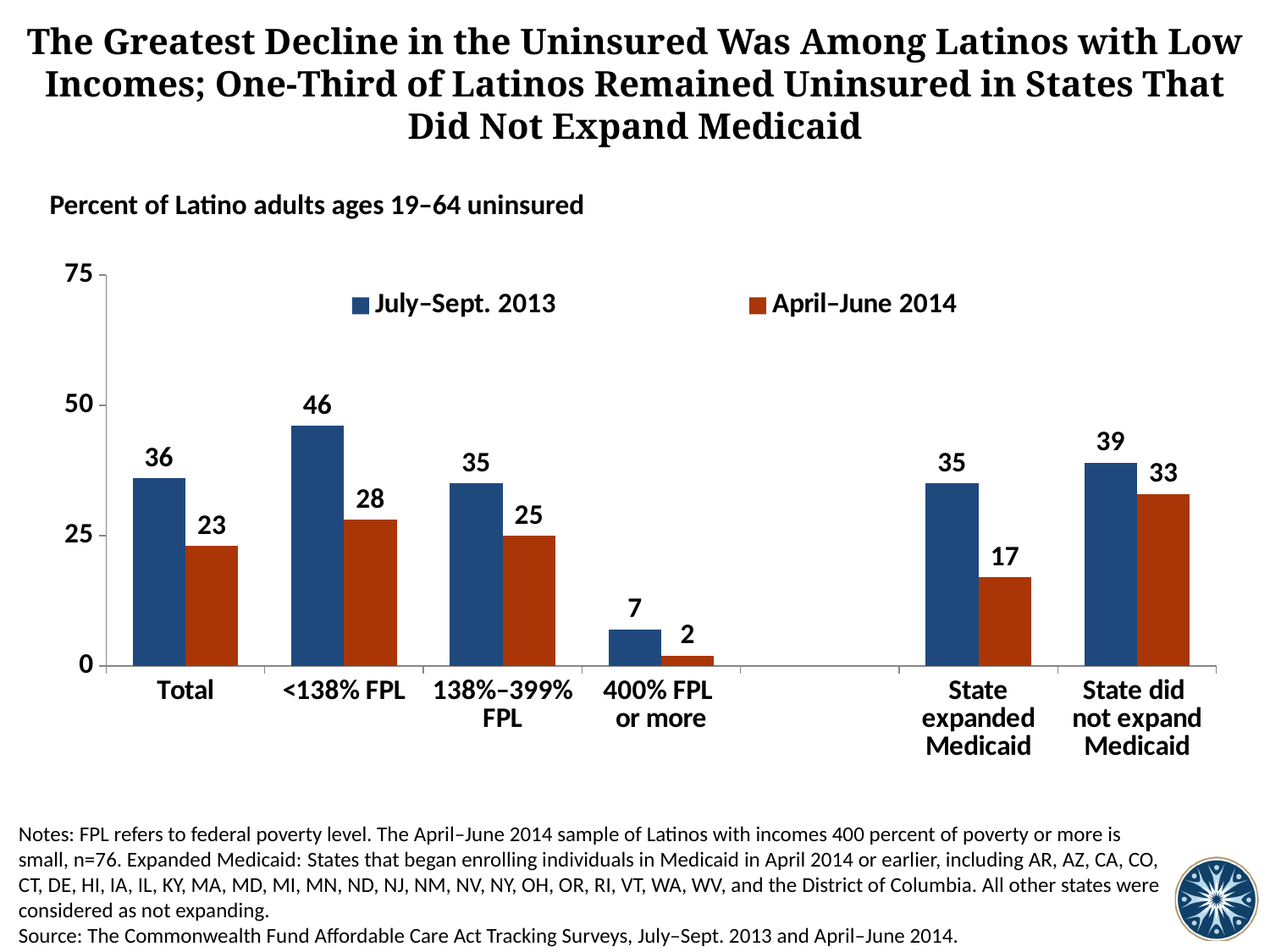
What is the April–June 2014 value for State expanded Medicaid? 17 What is the difference between the April–June 2014 values for State did not expand Medicaid and State expanded Medicaid? 16 Which category has the highest July–Sept. 2013 value? <138% FPL What is the April–June 2014 value for <138% FPL? 28 What kind of chart is shown on the slide? bar chart How many categories are shown on the x axis? 6 How many series does the legend list? 2 What is the July–Sept. 2013 value for Total? 36 Which category has the lowest April–June 2014 value? 400% FPL or more Which is larger: the April–June 2014 value for 138%–399% FPL or the April–June 2014 value for Total? 138%–399% FPL Is the July–Sept. 2013 value for State did not expand Medicaid greater or less than 25? greater What is the difference between the July–Sept. 2013 and April–June 2014 values for <138% FPL? 18